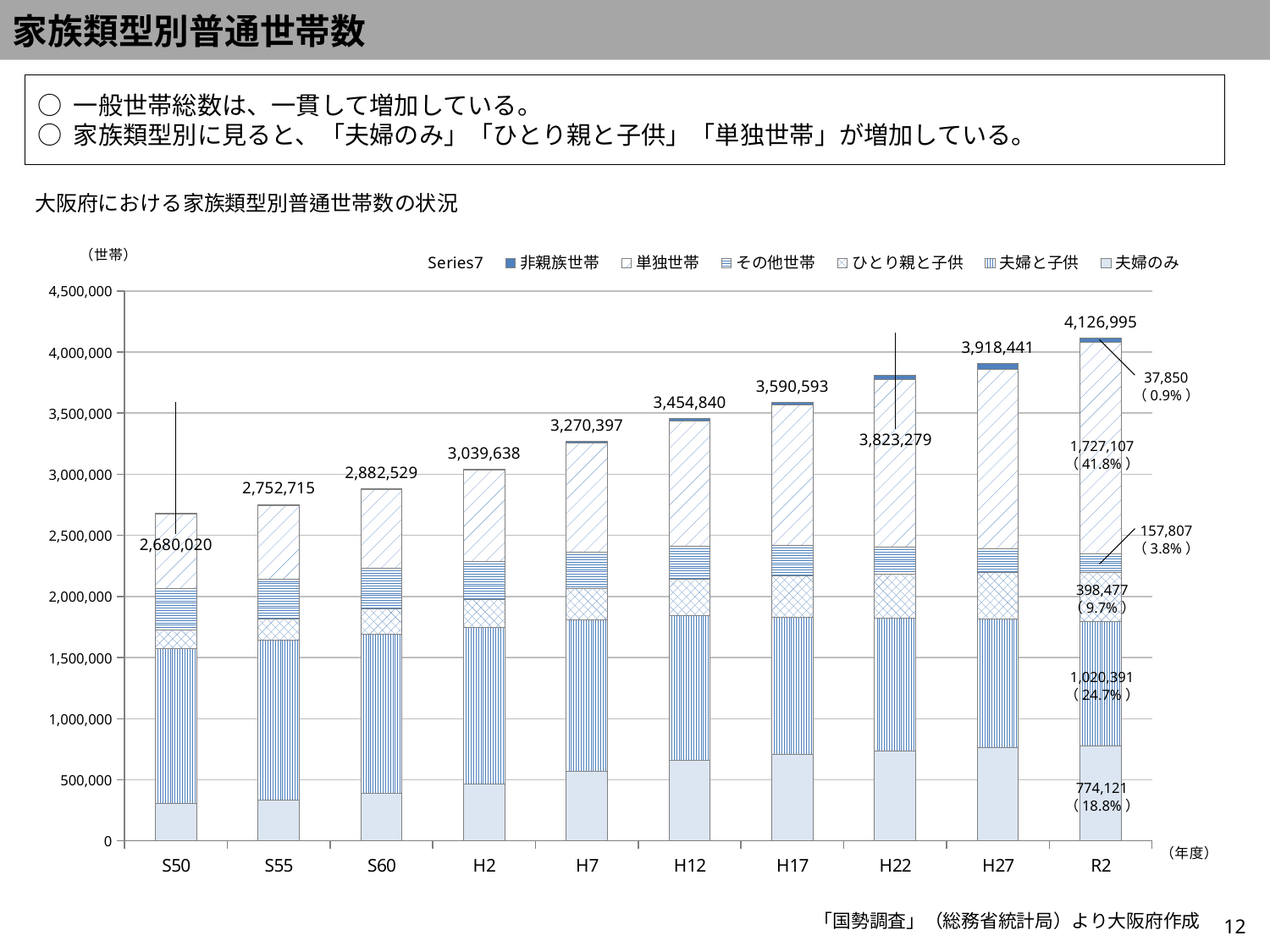
What is the value of 単独世帯 in R2? 1,727,107 How many years (categories) are shown on the x axis? 10 Do the total household numbers rise or fall from S50 to R2? Rise What is the difference between the total households in R2 and in H27? 208,554 Which year has the highest total number of households? R2 Which year has a larger total number of households, H12 or H17? H17 What share of households in R2 is 夫婦のみ? 18.8% What is the total number of households shown for R2? 4,126,995 What is the total number of households shown for H22? 3,823,279 What is the total number of households shown for S50? 2,680,020 Which year has the lowest total number of households? S50 What kind of chart is shown on the slide? Stacked bar chart